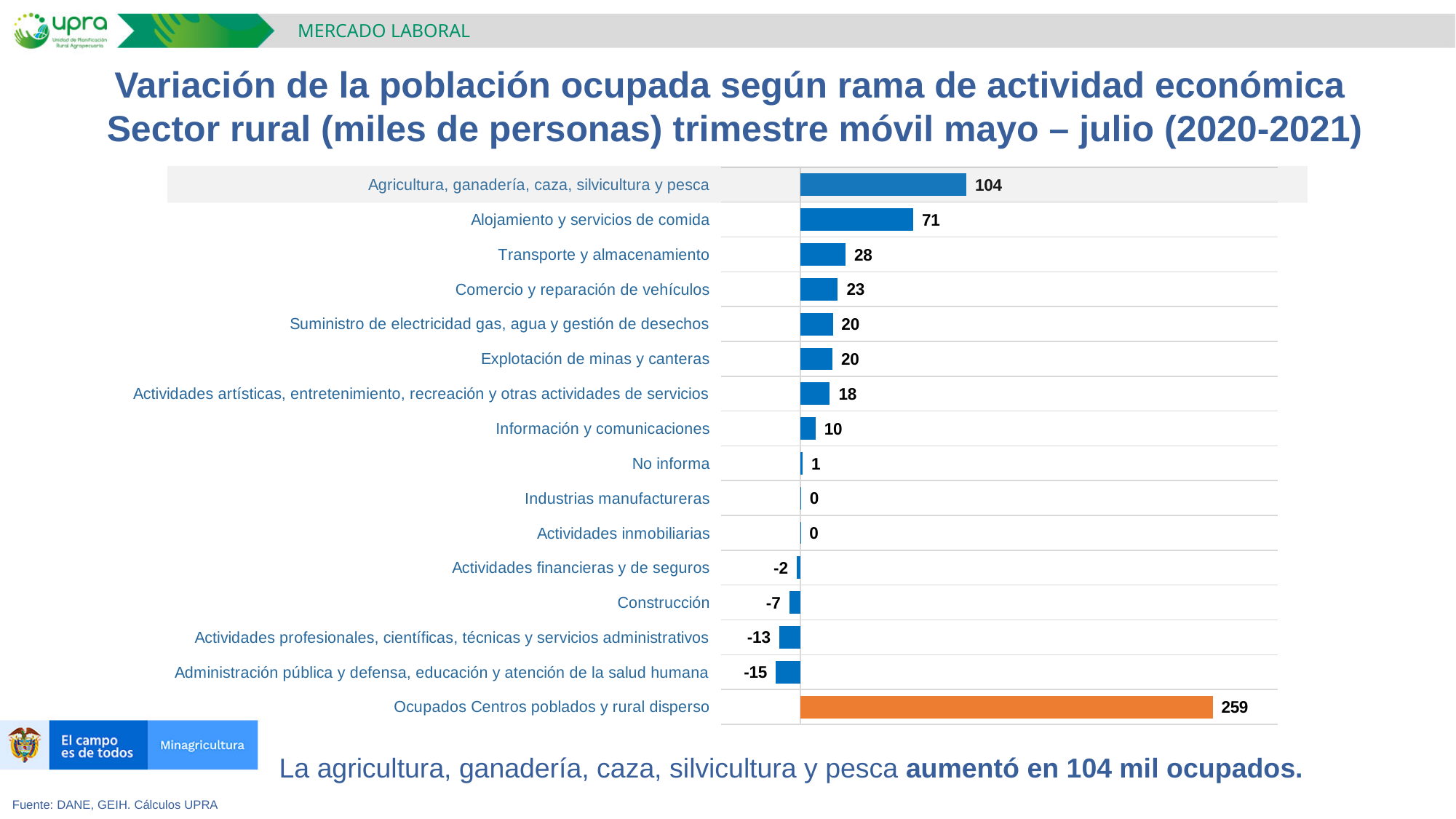
What is the value for Construcción? -7 What is the difference between the values for Agricultura, ganadería, caza, silvicultura y pesca and Alojamiento y servicios de comida? 33 What is the value for Actividades profesionales, científicas, técnicas y servicios administrativos? -13 Which bar is shown in orange rather than blue? Ocupados Centros poblados y rural disperso Which category has the highest value? Ocupados Centros poblados y rural disperso What kind of chart is shown on the slide? Bar chart What is the value for Alojamiento y servicios de comida? 71 Which is larger, the value for Transporte y almacenamiento or the value for Comercio y reparación de vehículos? Transporte y almacenamiento Which category has the lowest value? Administración pública y defensa, educación y atención de la salud humana How many categories are shown in the chart? 16 What is the value for Agricultura, ganadería, caza, silvicultura y pesca? 104 What is the value for Ocupados Centros poblados y rural disperso? 259